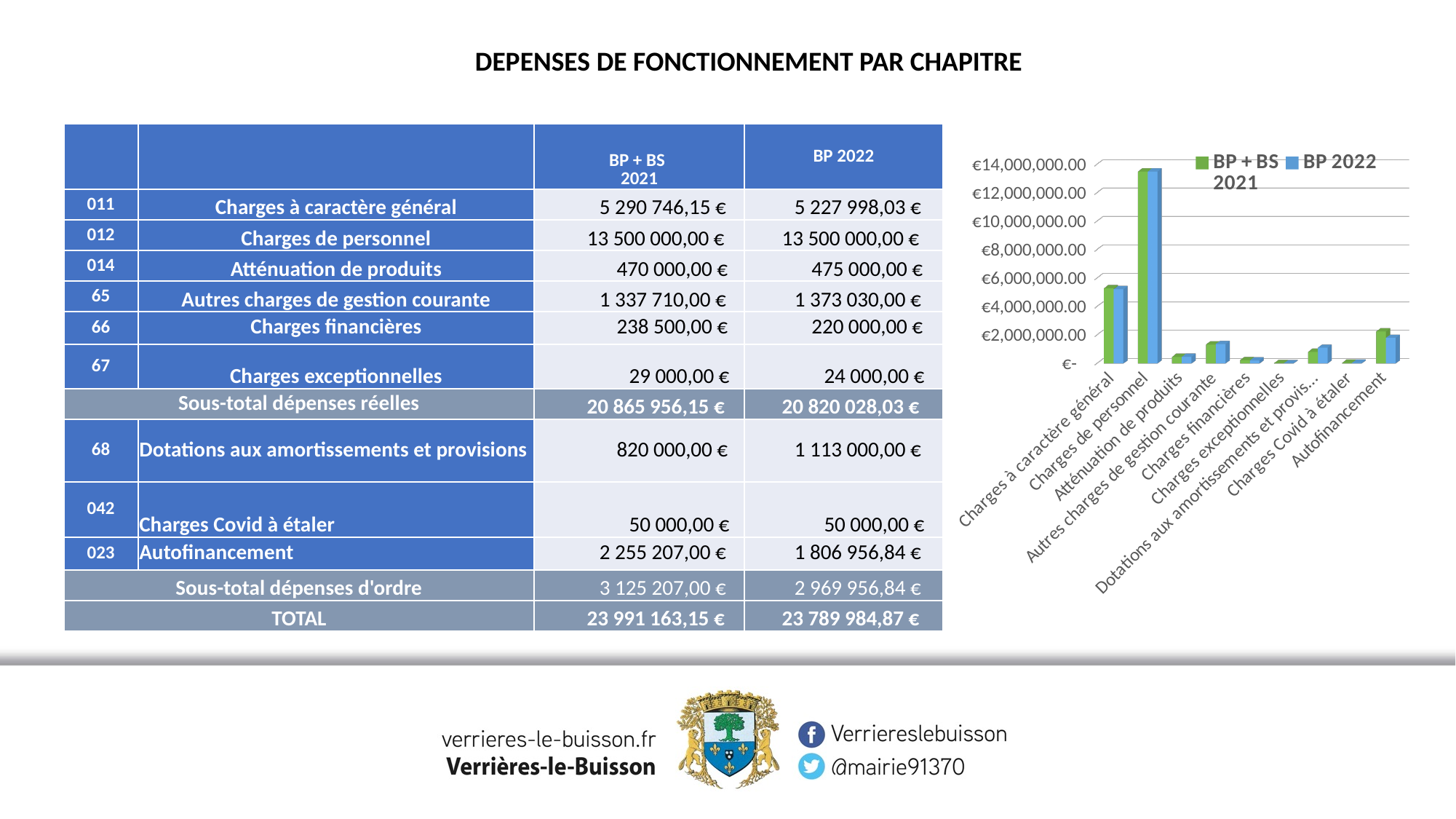
Which colour represents the BP 2022 series in the chart? blue Is the BP 2022 value for Charges de personnel greater or less than €12,000,000.00? greater Is the BP + BS 2021 value for Charges à caractère général greater or less than €6,000,000.00? less Which is larger in the chart: the BP 2022 value for Autofinancement or the BP 2022 value for Charges financières? Autofinancement Which category has the highest bars in the chart? Charges de personnel Is the BP 2022 value for Autres charges de gestion courante greater or less than €2,000,000.00? less According to the slide, what is the BP 2022 value for Charges de personnel? 13 500 000,00 € What kind of chart is shown on the right of the slide? bar chart What is the difference between the BP + BS 2021 and BP 2022 values for Charges à caractère général shown on the slide? 62 748,12 € How many categories are shown along the x axis of the chart? 9 How many series does the chart's legend list? 2 According to the slide, what is the BP + BS 2021 value for Autofinancement? 2 255 207,00 €